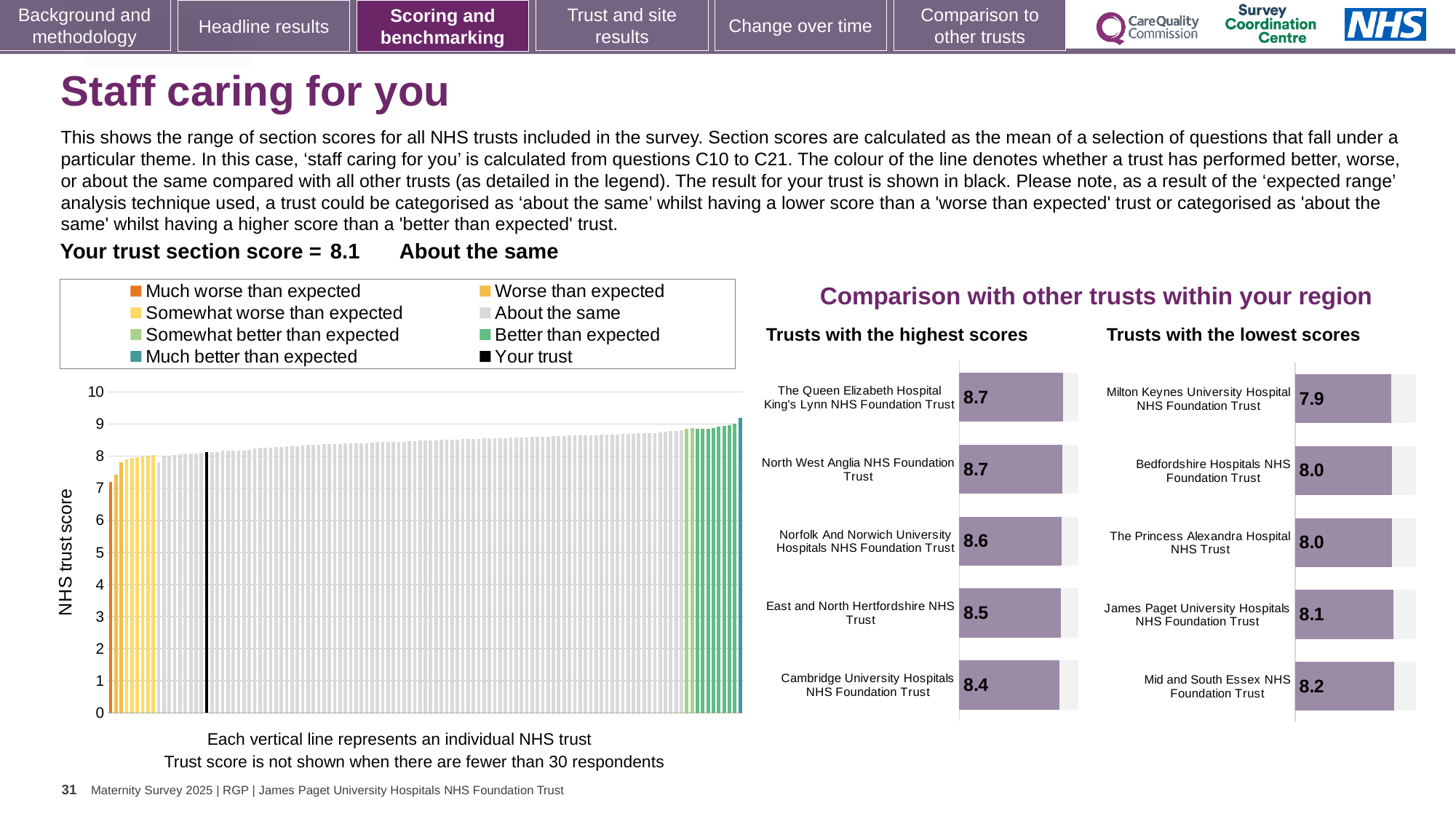
How many trusts are listed in the 'Trusts with the highest scores' chart? 5 In the 'Trusts with the highest scores' chart, which has the higher score: Norfolk And Norwich University Hospitals NHS Foundation Trust or East and North Hertfordshire NHS Trust? Norfolk And Norwich University Hospitals NHS Foundation Trust In the 'Trusts with the lowest scores' chart, what is the score for Milton Keynes University Hospital NHS Foundation Trust? 7.9 In the 'Trusts with the lowest scores' chart, which trust has the lowest score? Milton Keynes University Hospital NHS Foundation Trust In the 'Trusts with the highest scores' chart, what is the score for Cambridge University Hospitals NHS Foundation Trust? 8.4 In the 'Trusts with the lowest scores' chart, what is the difference between the score for Mid and South Essex NHS Foundation Trust and the score for Milton Keynes University Hospital NHS Foundation Trust? 0.3 In the main NHS trust score chart, is the value of the leftmost bar greater or less than 8? less How many entries does the legend of the main NHS trust score chart list? 8 In the 'Trusts with the highest scores' chart, what is the difference between the score for The Queen Elizabeth Hospital King's Lynn NHS Foundation Trust and the score for Cambridge University Hospitals NHS Foundation Trust? 0.3 In the main NHS trust score chart, do the values rise or fall from left to right? rise What kind of chart is the main NHS trust score chart on the left of the slide? bar chart In the 'Trusts with the lowest scores' chart, what is the score for James Paget University Hospitals NHS Foundation Trust? 8.1